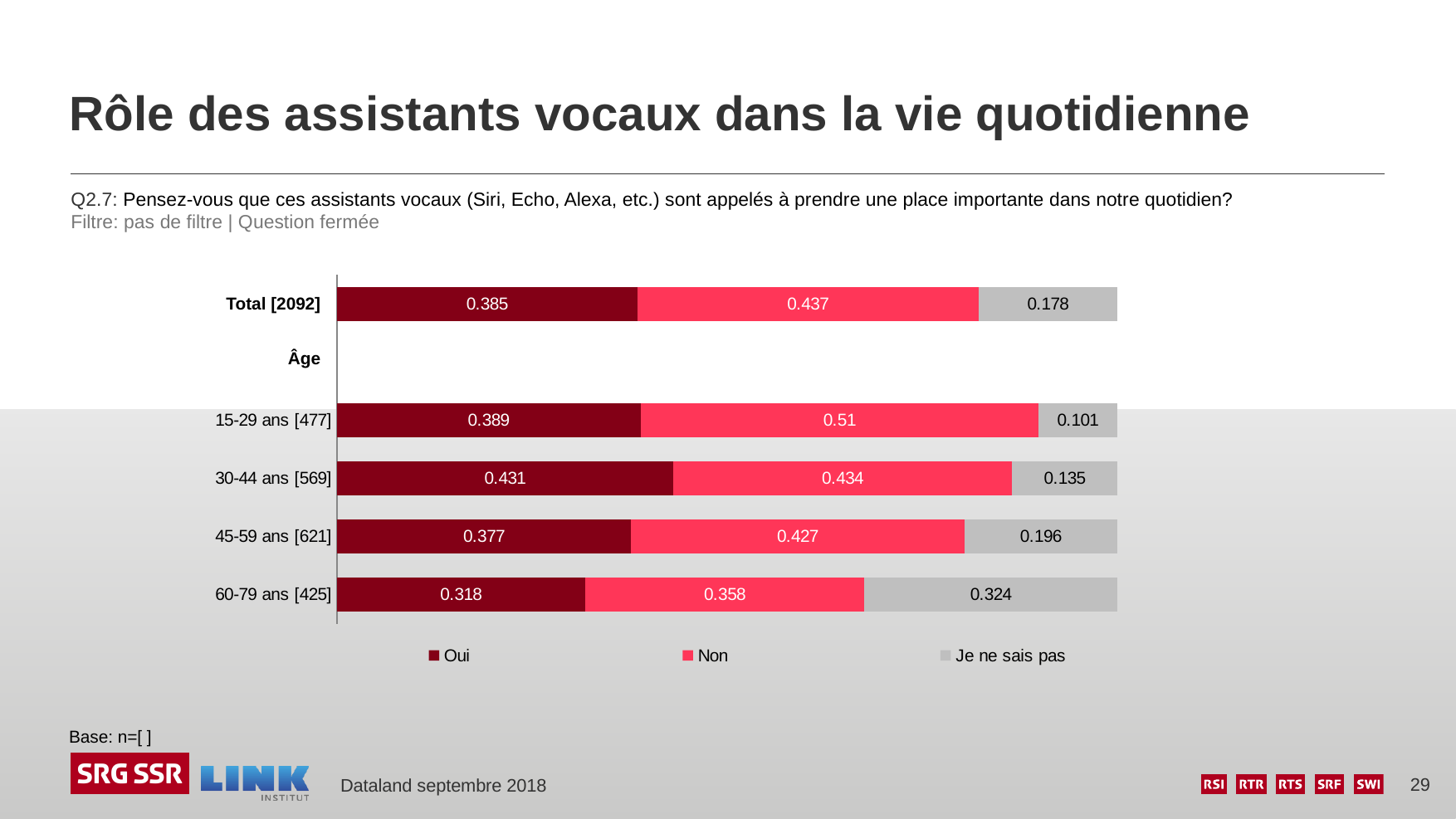
What is the difference between the 'Non' value for 15-29 ans and the 'Non' value for 60-79 ans? 0.152 How many age groups are plotted (excluding the Total bar)? 4 What is the 'Je ne sais pas' value for the 60-79 ans group? 0.324 What is the 'Non' value for the 15-29 ans group? 0.51 How many series does the legend list? 3 What is the 'Non' value for Total [2092]? 0.437 What kind of chart is shown on the slide? Stacked bar chart Which legend entry is shown in grey? Je ne sais pas Which age group has the lowest 'Je ne sais pas' value? 15-29 ans What is the 'Oui' value for the 30-44 ans group? 0.431 Which age group has the highest 'Oui' value? 30-44 ans Which is larger: the 'Oui' value for 45-59 ans or the 'Oui' value for 60-79 ans? 45-59 ans